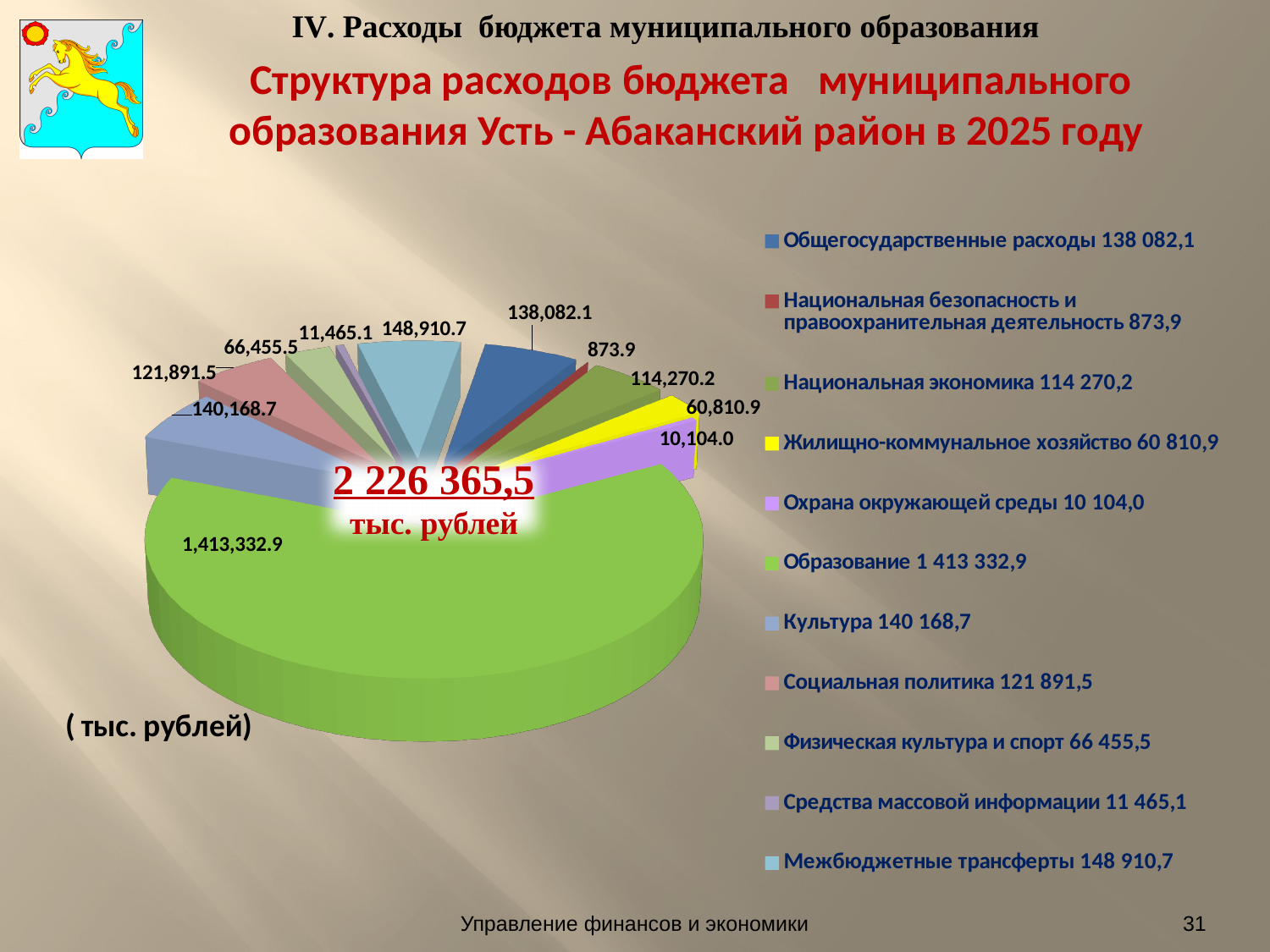
Which is larger, the value for Национальная экономика or the value for Социальная политика? Социальная политика What is the value for Межбюджетные трансферты? 148,910.7 What total amount is shown in the centre of the pie chart? 2 226 365,5 тыс. рублей What is the value for Средства массовой информации? 11,465.1 What is the value for Образование? 1,413,332.9 How many categories does the pie chart have? 11 What type of chart is shown on the slide? Pie chart Which category has the largest slice? Образование What is the value for Жилищно-коммунальное хозяйство? 60,810.9 How many entries does the legend list? 11 Which category has the smallest slice? Национальная безопасность и правоохранительная деятельность What is the difference between the values for Культура and Социальная политика? 18,277.2